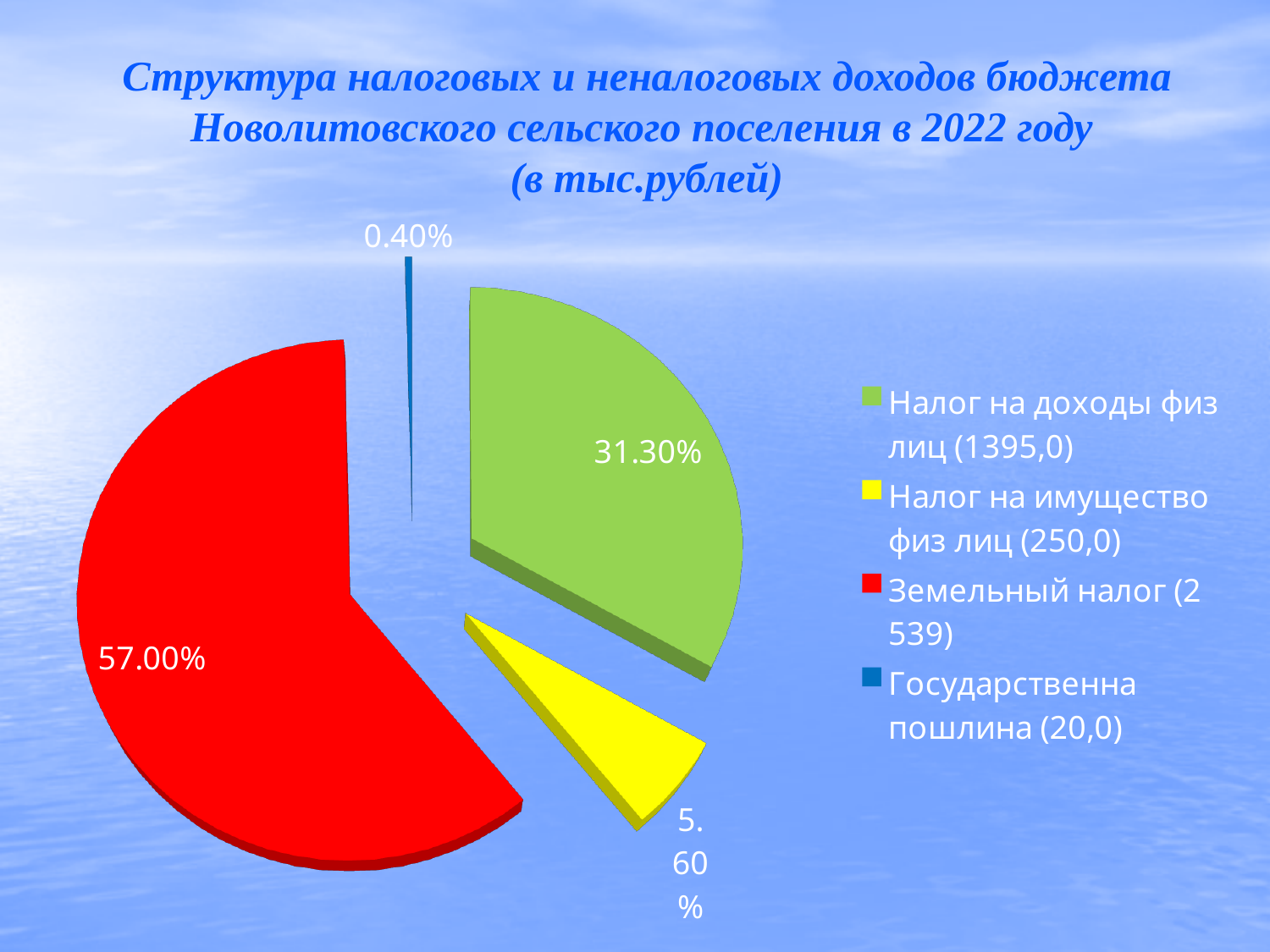
Which slice is larger: Налог на имущество физ лиц or Налог на доходы физ лиц? Налог на доходы физ лиц Which category has the smallest slice of the pie? Государственна пошлина (20,0) What kind of chart is shown on the slide? pie chart Which category has the largest slice of the pie? Земельный налог (2 539) What share of the pie does Государственна пошлина (20,0) have? 0.40% How many entries does the legend list? 4 What share of the pie does Налог на доходы физ лиц (1395,0) have? 31.30% What colour is the slice for Земельный налог? red How many slices does the pie chart have? 4 What share of the pie does Налог на имущество физ лиц (250,0) have? 5.60% What is the difference in percentage points between the Земельный налог slice and the Налог на доходы физ лиц slice? 25.70%